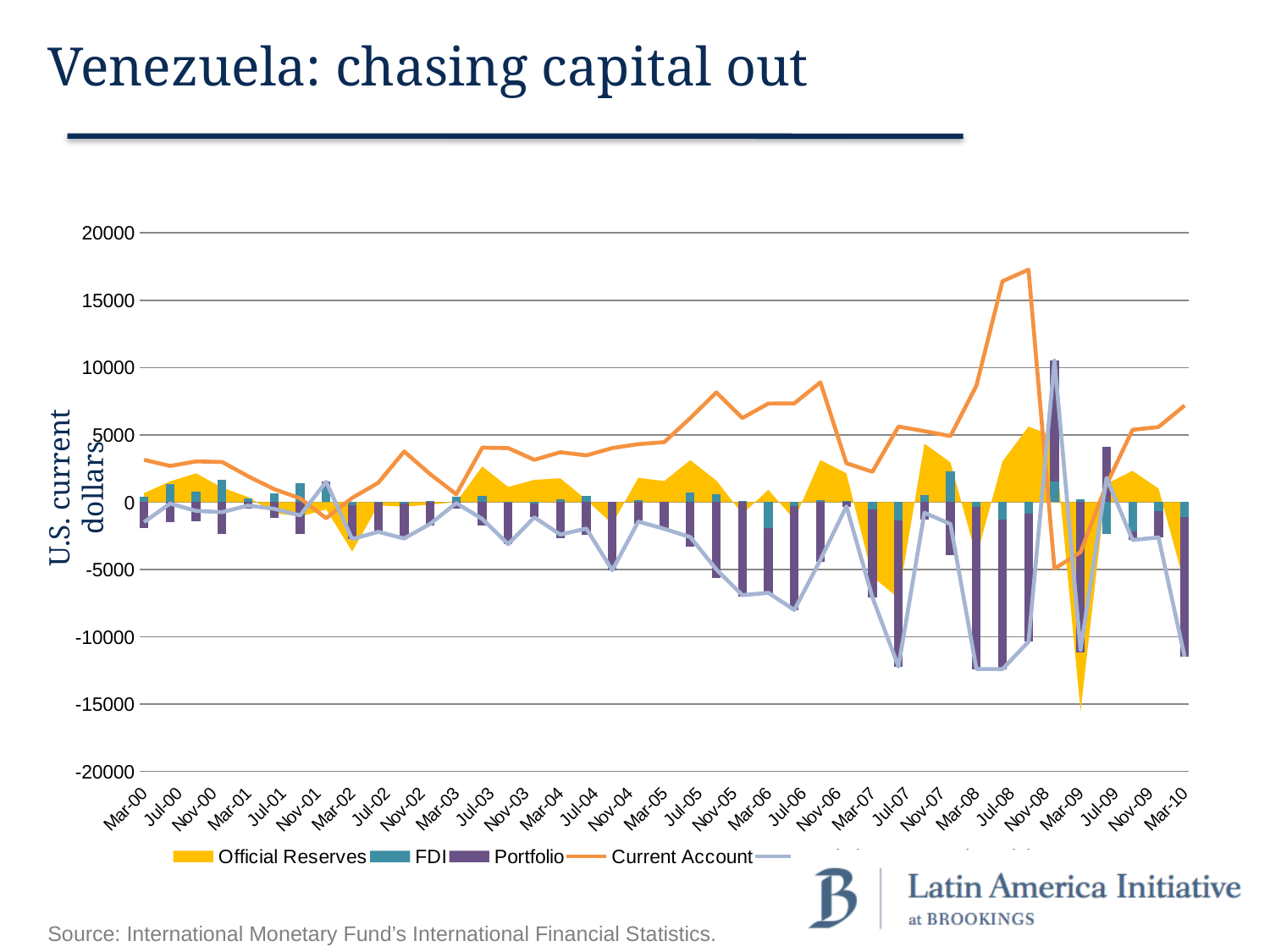
Does the Current Account line generally rise or fall from Mar-00 to Jul-08? rise In which year does the Current Account line reach its highest point? 2008 Is the Portfolio bar at Nov-08 greater or less than 5000? greater Which is larger, the Current Account value at Jul-08 or at Mar-00? Jul-08 Is the peak value of the Current Account line in 2008 greater or less than 15000? greater What is the title of the slide's chart? Venezuela: chasing capital out At which x-axis label does the Official Reserves series reach its lowest point? Mar-09 What label is shown on the vertical axis of the chart? U.S. current dollars Is the Current Account value at Mar-10 greater or less than 5000? greater What kind of chart is shown on the slide? A combination chart of bars, an area and lines